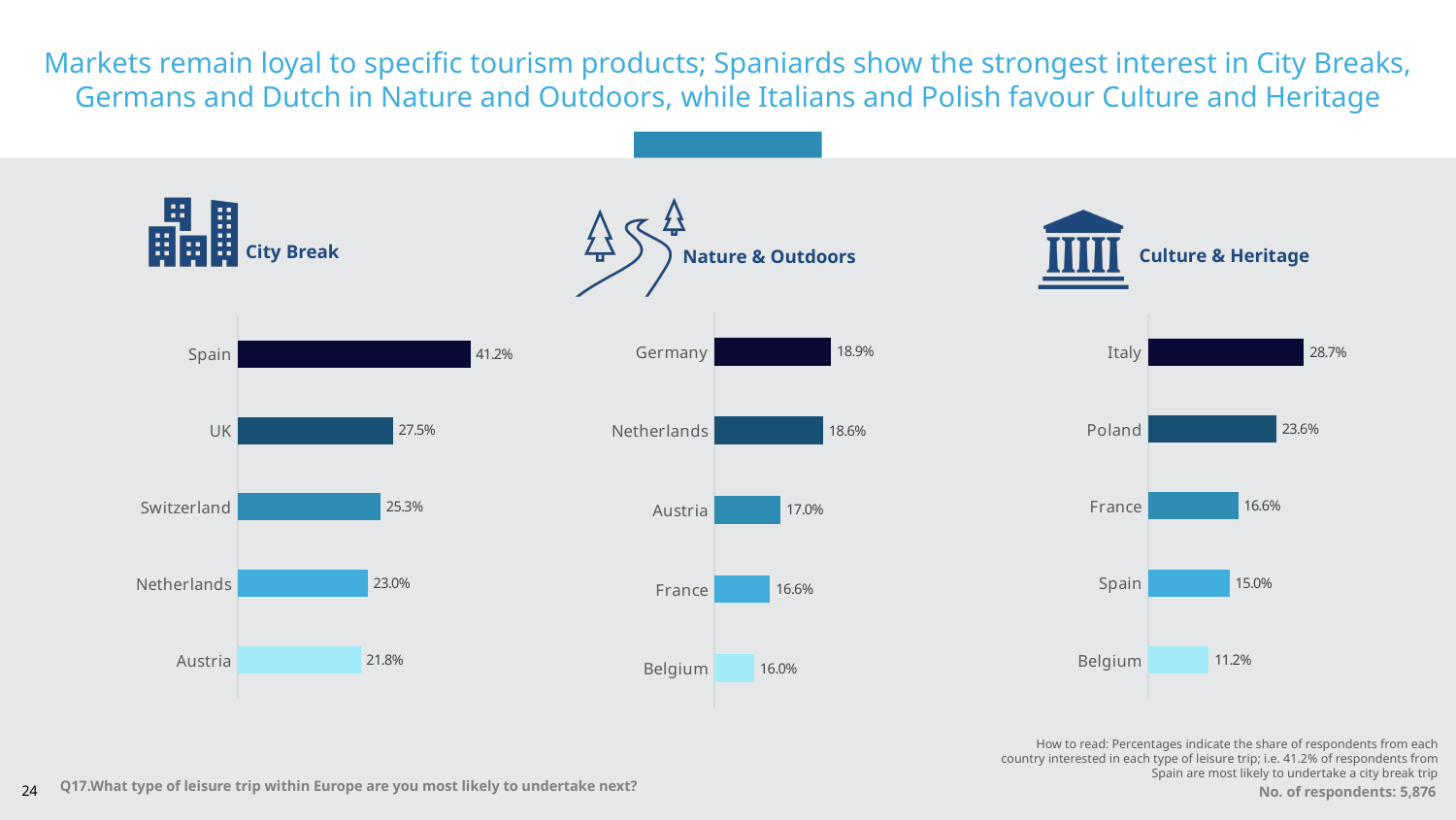
In the Culture & Heritage chart, what is the value for Poland? 23.6% In the City Break chart, what is the value for Spain? 41.2% How many charts are shown on the slide? 3 In the Culture & Heritage chart, what is the difference between the values for Italy and Belgium? 17.5% What kind of chart is the City Break chart? Bar chart In the Nature & Outdoors chart, which is larger, the value for Germany or the value for Belgium? Germany In the Nature & Outdoors chart, which country has the lowest value? Belgium How many countries are shown in the Culture & Heritage chart? 5 In the Culture & Heritage chart, which country has the highest value? Italy In the City Break chart, what is the difference between the values for Spain and the UK? 13.7% In the Nature & Outdoors chart, what is the value for Austria? 17.0% In the City Break chart, which country has the lowest value? Austria